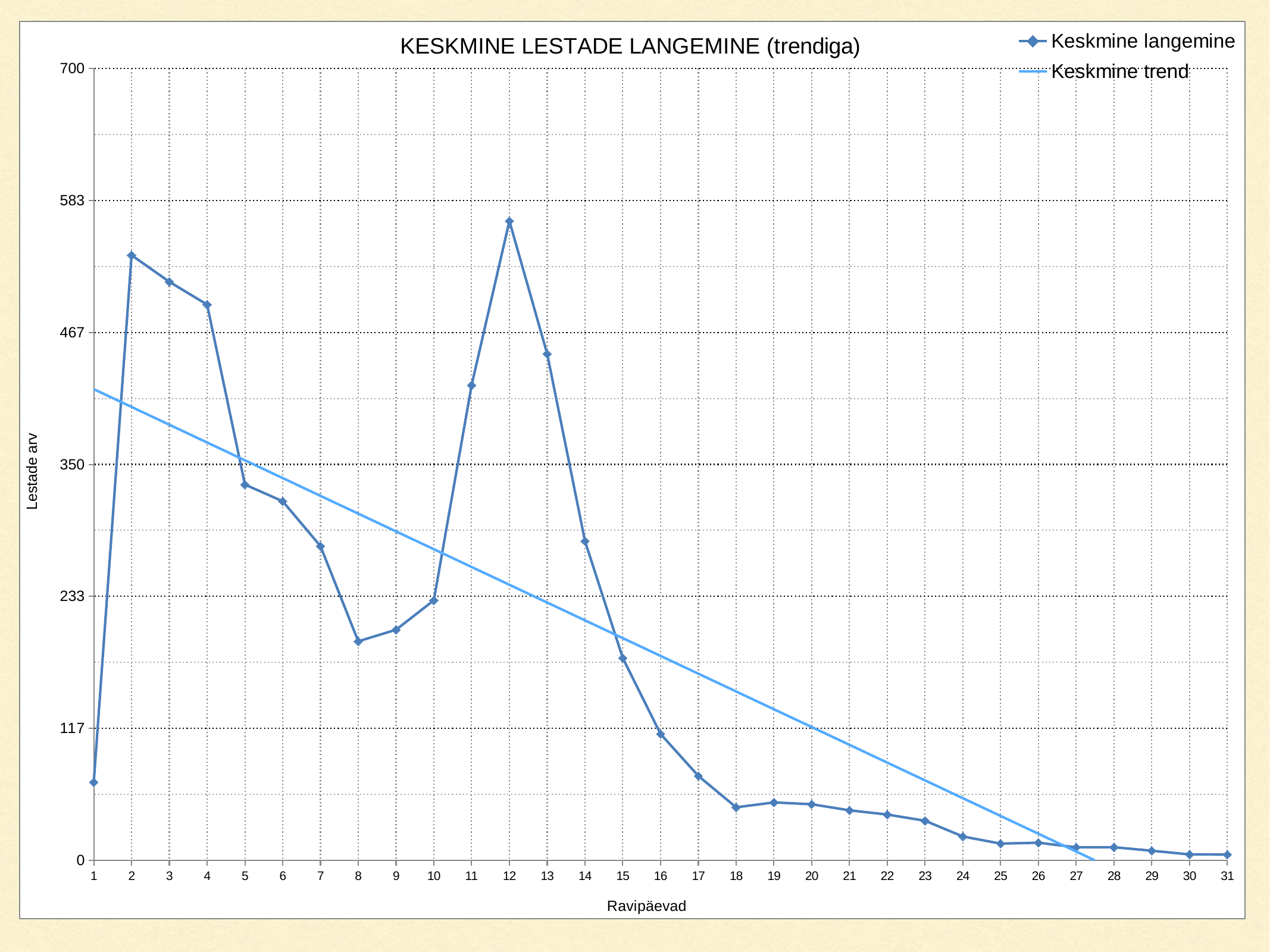
Does the Keskmine trend line rise or fall from day 1 to day 31? fall On which day does the Keskmine langemine series reach its highest value? 12 Is the Keskmine langemine value on day 12 greater or less than 467? greater How many treatment days (Ravipäevad) are plotted on the x axis? 31 How many series does the legend list? 2 Is the Keskmine langemine value on day 8 greater or less than 233? less Is the Keskmine langemine value on day 2 greater or less than 467? greater Which has the higher Keskmine langemine value, day 2 or day 12? day 12 What are the two series named in the legend? Keskmine langemine, Keskmine trend What is the title of the chart? KESKMINE LESTADE LANGEMINE (trendiga) What kind of chart is shown on the slide? line chart